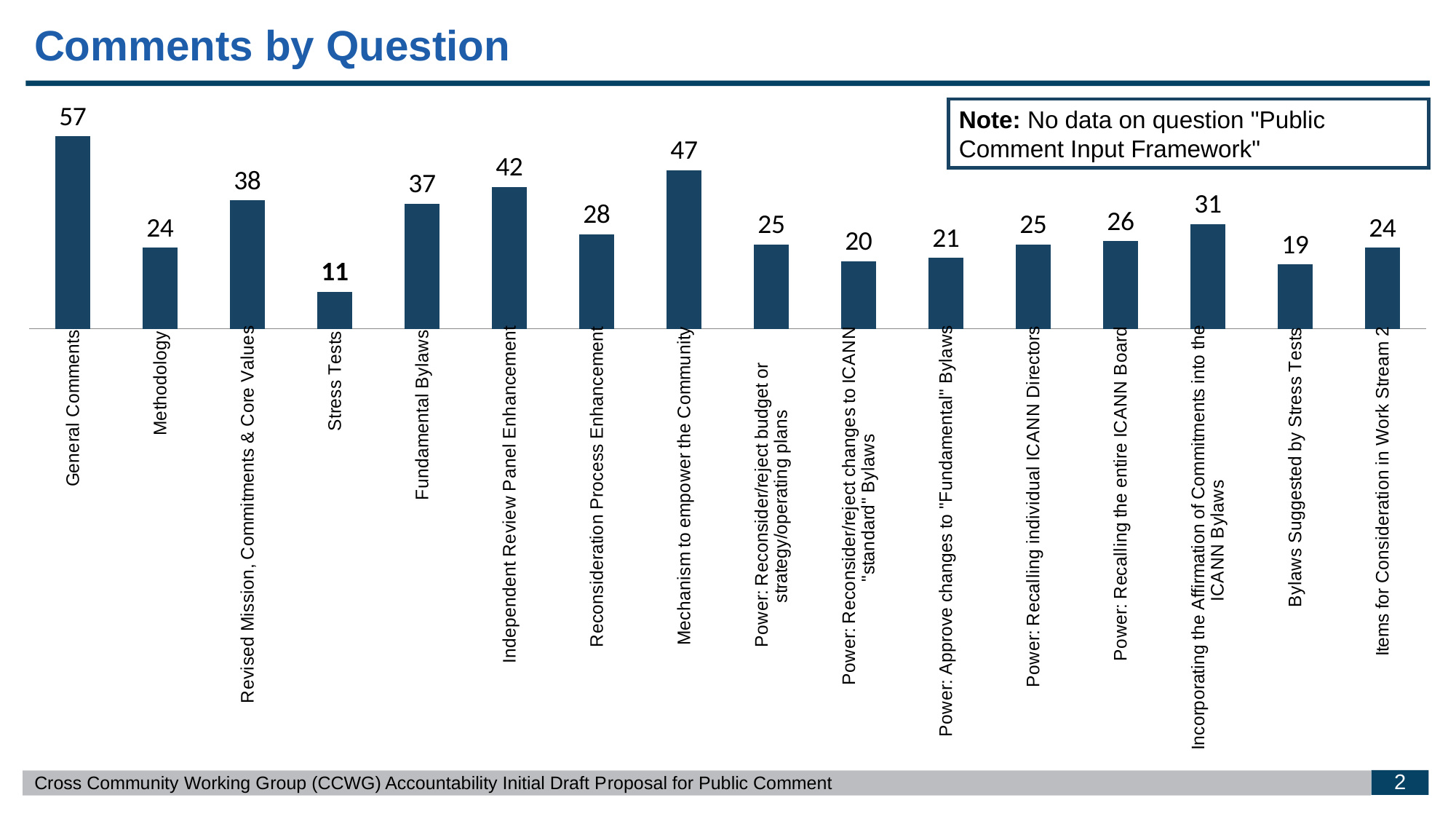
What is the difference between the values for General Comments and Mechanism to empower the Community? 10 What is the difference between the values for Independent Review Panel Enhancement and Fundamental Bylaws? 5 What kind of chart is shown on the slide? Bar chart Which category has the highest value? General Comments Which is larger, the value for Revised Mission, Commitments & Core Values or the value for Incorporating the Affirmation of Commitments into the ICANN Bylaws? Revised Mission, Commitments & Core Values Which category has the lowest value? Stress Tests How many categories are shown in the chart? 16 What is the value for General Comments? 57 What is the value for Stress Tests? 11 What is the value for Mechanism to empower the Community? 47 What is the value for Bylaws Suggested by Stress Tests? 19 What is the title of the chart? Comments by Question